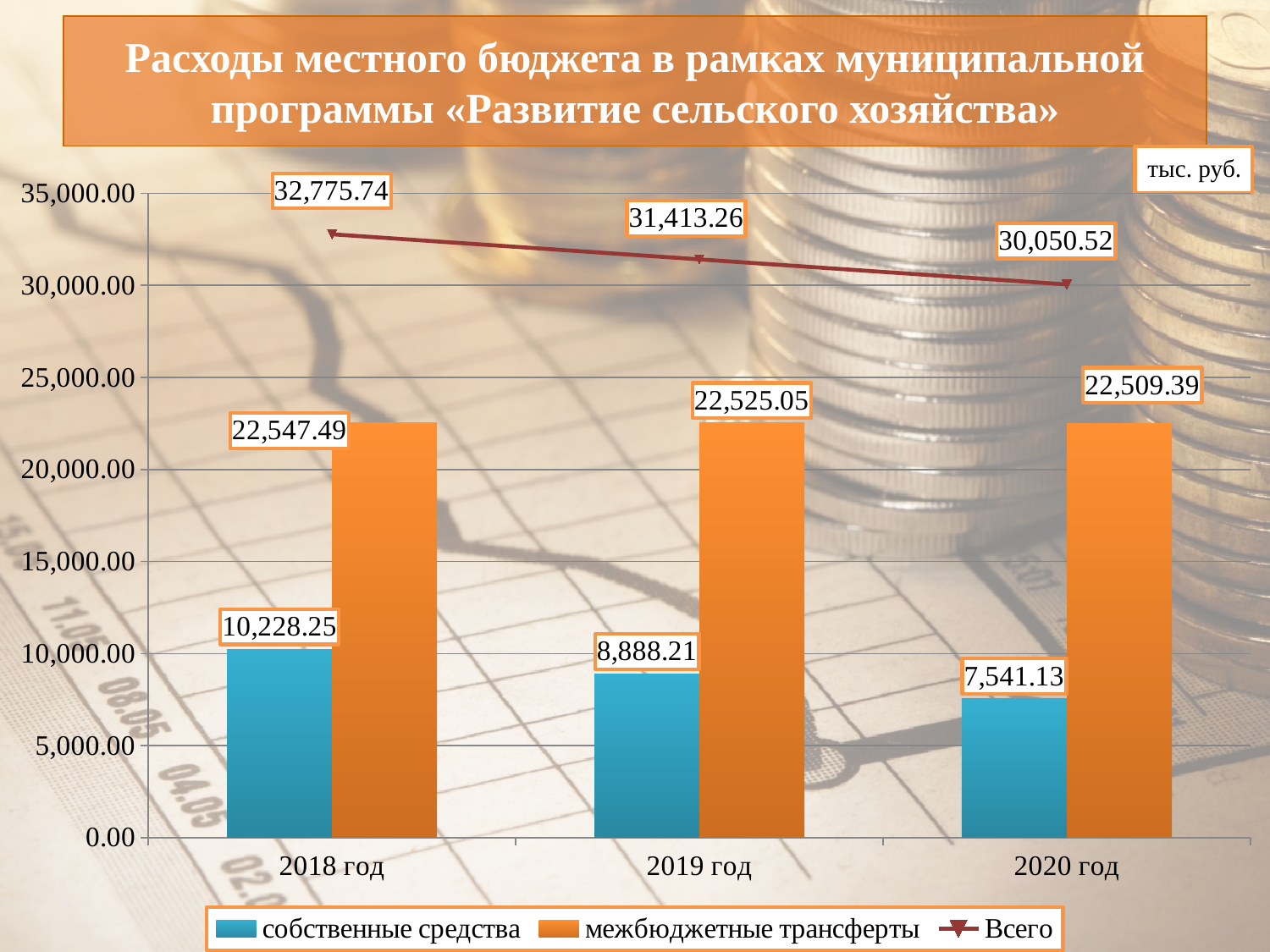
What is the value of Всего for 2019 год? 31,413.26 How many series does the legend list? 3 How does Всего change from 2018 год to 2020 год? It falls In which year is Всего the highest? 2018 год Which is larger: межбюджетные трансферты in 2018 год or in 2019 год? 2018 год Is the value for собственные средства in 2019 год greater or less than 10,000.00? less What is the value for межбюджетные трансферты in 2020 год? 22,509.39 What is the difference between Всего in 2018 год and 2020 год? 2,725.22 What is the value for собственные средства in 2018 год? 10,228.25 In which year is собственные средства the lowest? 2020 год What is the difference between собственные средства in 2018 год and 2020 год? 2,687.12 How many years are shown on the x axis? 3